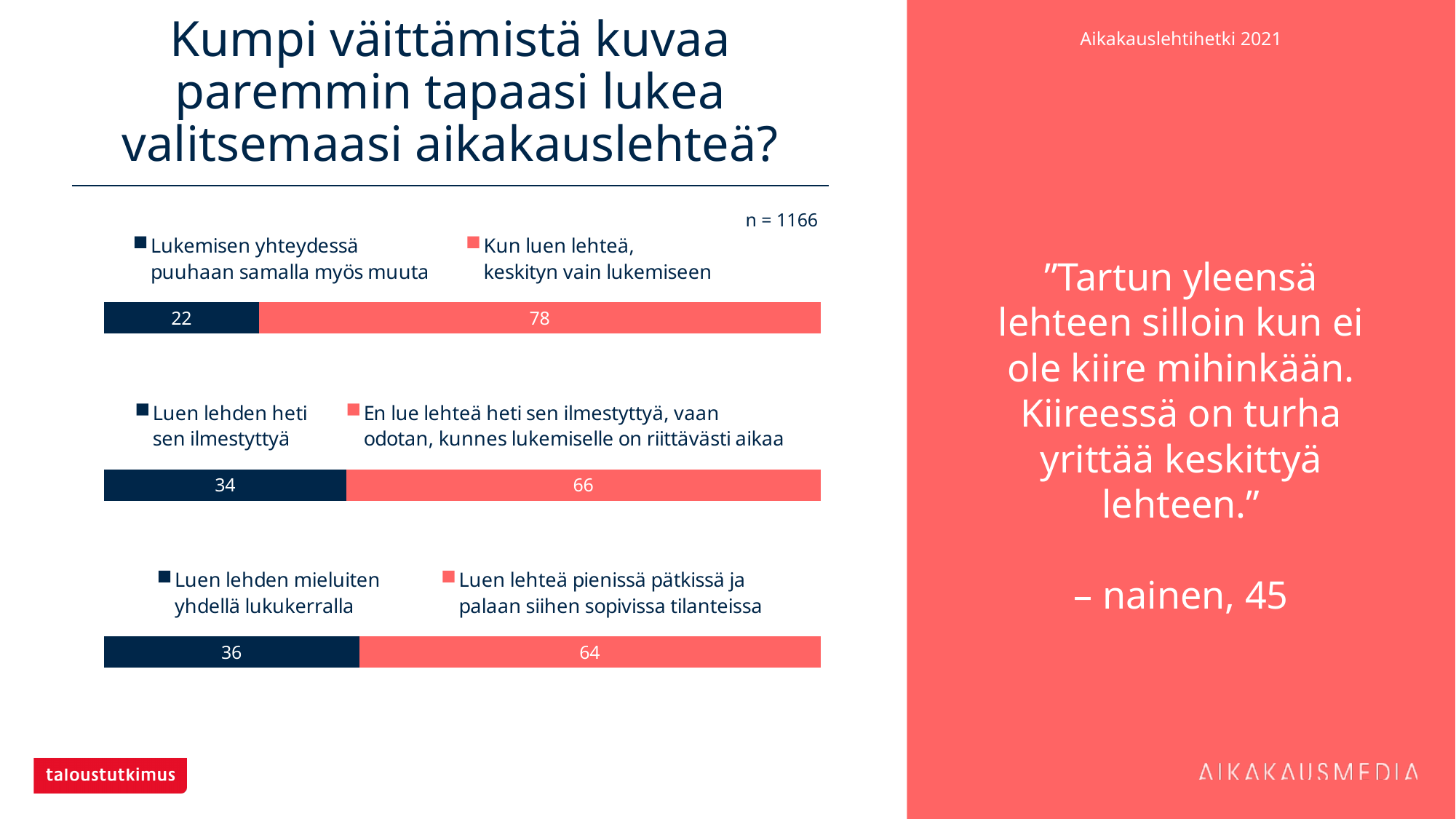
In the middle bar chart, what is the value for "Luen lehden heti sen ilmestyttyä"? 34 What sample size (n) is shown above the charts? n = 1166 In the top bar chart, what is the difference between the values for "Kun luen lehteä, keskityn vain lukemiseen" and "Lukemisen yhteydessä puuhaan samalla myös muuta"? 56 In the middle bar chart, what is the total of the stacked bar? 100 How many series does the legend of the top bar chart list? 2 In the top bar chart, what is the value for "Kun luen lehteä, keskityn vain lukemiseen"? 78 What kind of chart is the middle chart on the slide? Stacked bar chart In the bottom bar chart, which is larger: "Luen lehden mieluiten yhdellä lukukerralla" or "Luen lehteä pienissä pätkissä ja palaan siihen sopivissa tilanteissa"? Luen lehteä pienissä pätkissä ja palaan siihen sopivissa tilanteissa In the middle bar chart, what is the value for "En lue lehteä heti sen ilmestyttyä, vaan odotan, kunnes lukemiselle on riittävästi aikaa"? 66 In the top bar chart, what is the value for "Lukemisen yhteydessä puuhaan samalla myös muuta"? 22 In the bottom bar chart, what is the value for "Luen lehteä pienissä pätkissä ja palaan siihen sopivissa tilanteissa"? 64 In the bottom bar chart, what is the value for "Luen lehden mieluiten yhdellä lukukerralla"? 36